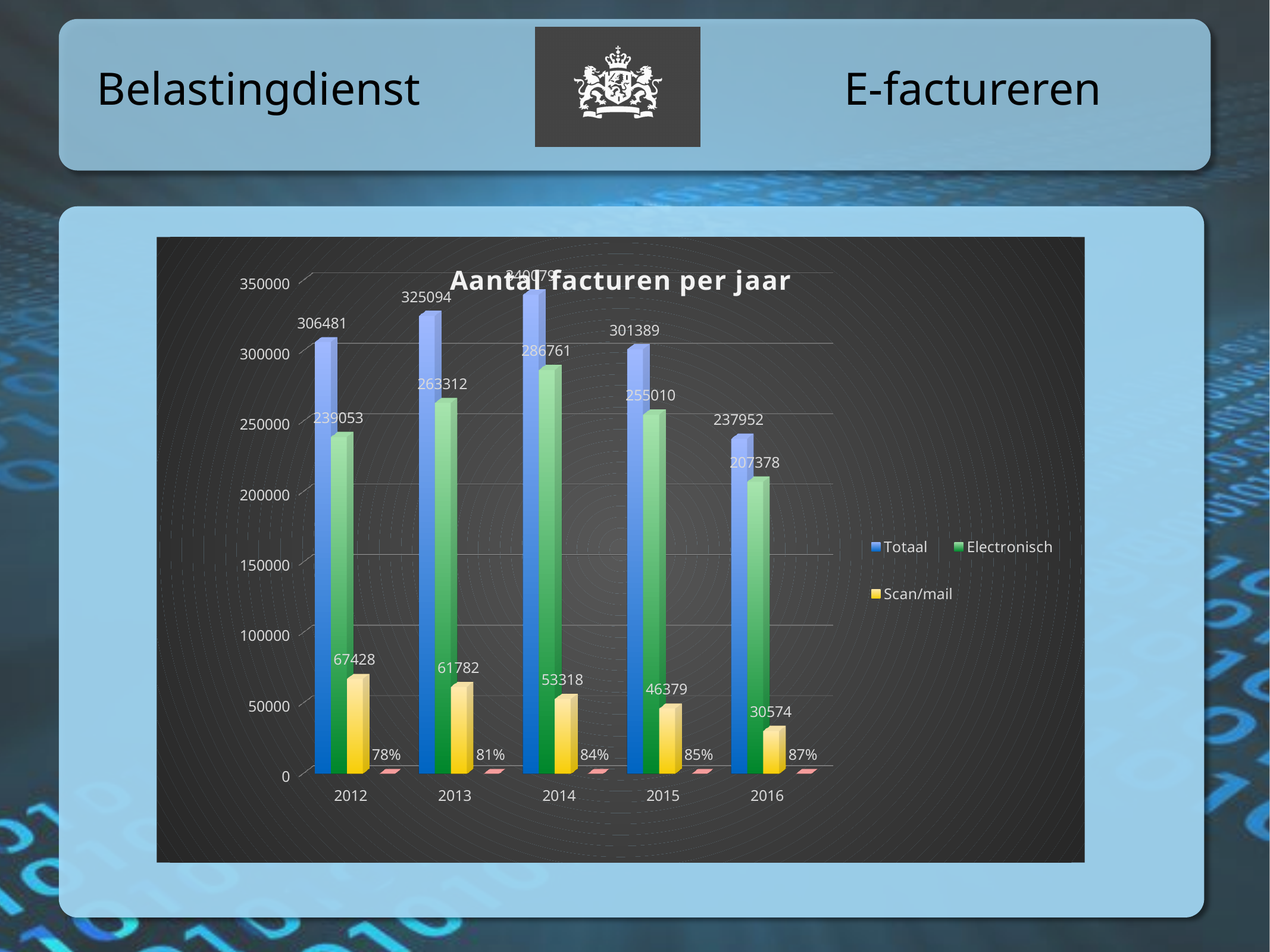
In which year is the Electronisch value lowest? 2016 In which year is the Scan/mail value highest? 2012 What is the Electronisch value for 2014? 286761 How many series does the legend list? 3 What is the title of the chart? Aantal facturen per jaar How many years are shown on the x axis? 5 What percentage is shown for 2015? 85% What is the Totaal value for 2012? 306481 Do the Scan/mail values rise or fall from 2012 to 2016? fall What is the difference between the Totaal value for 2013 and the Totaal value for 2015? 23705 What kind of chart is shown? bar chart Which year has the larger Electronisch value, 2013 or 2015? 2013